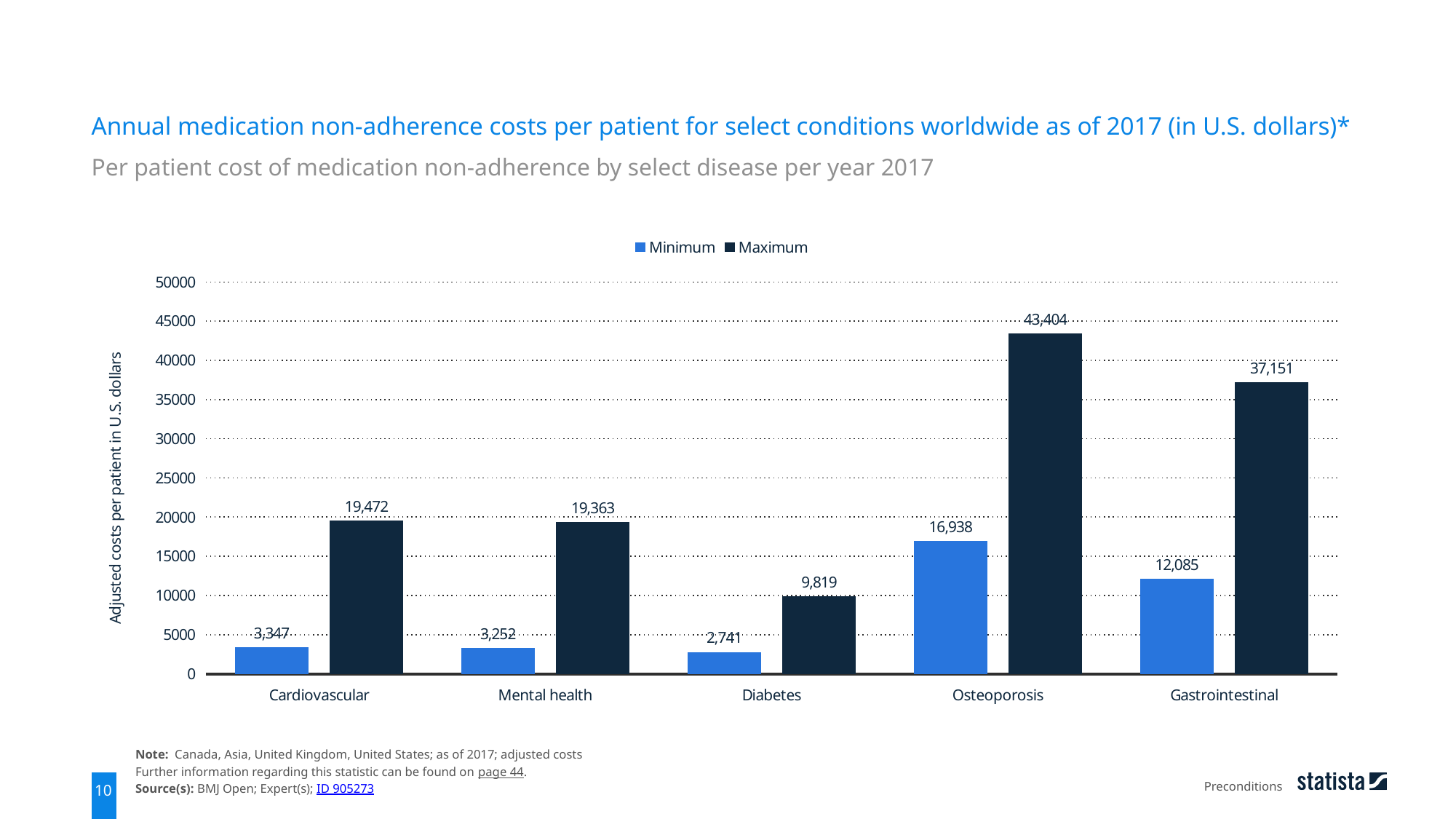
How many series does the legend list? 2 What is the difference between the Maximum and Minimum values for Gastrointestinal? 25,066 What is the Maximum value for Gastrointestinal? 37,151 What is the Minimum value for Diabetes? 2,741 Is the Maximum value for Diabetes greater or less than 10000? less Which is larger, the Minimum value for Osteoporosis or the Minimum value for Gastrointestinal? Osteoporosis Which condition has the lowest Minimum value? Diabetes What is the Maximum value for Osteoporosis? 43,404 How many conditions are shown on the x axis? 5 Which condition has the highest Maximum value? Osteoporosis What is the label of the y axis? Adjusted costs per patient in U.S. dollars What kind of chart is shown on the slide? bar chart